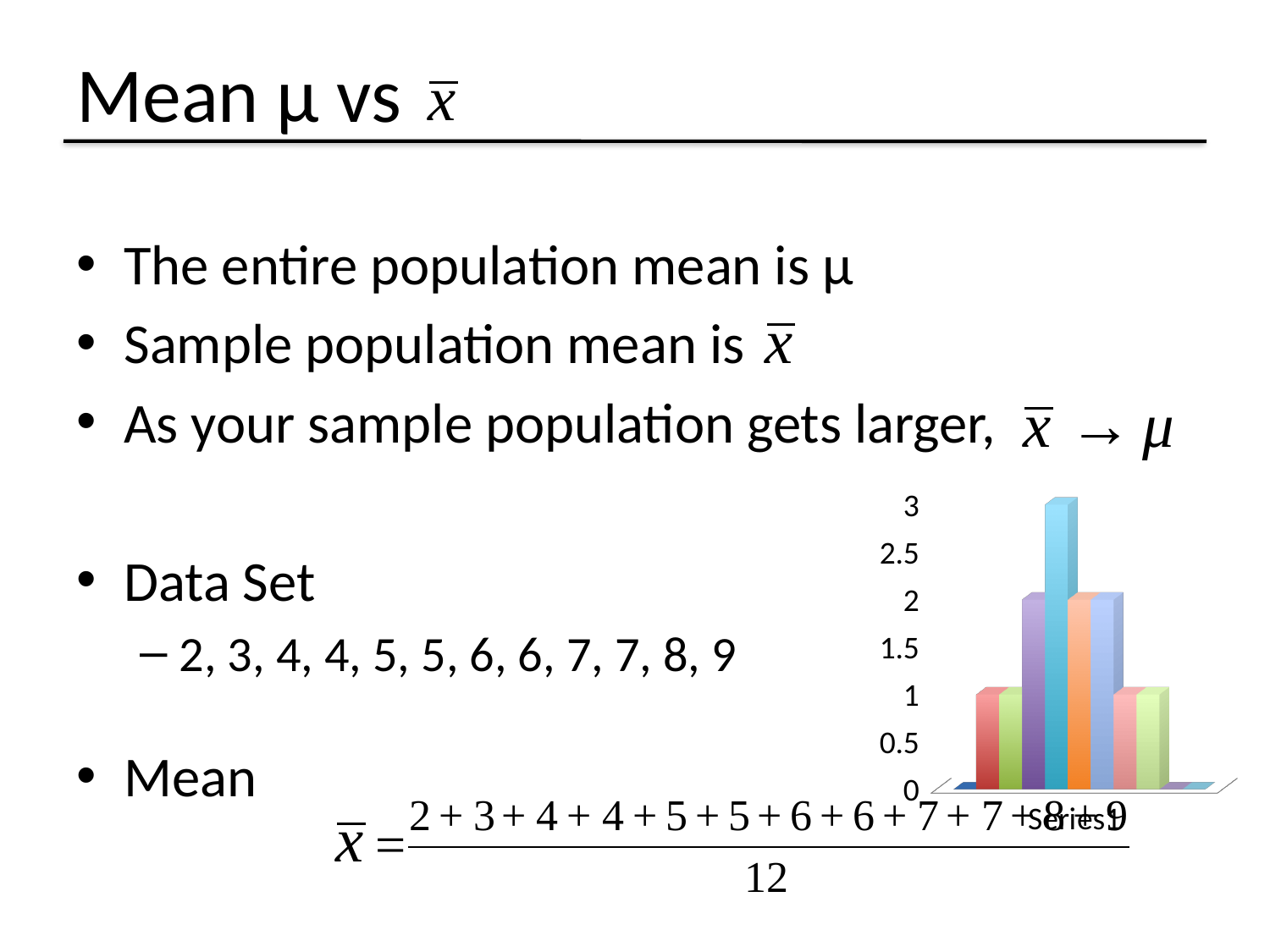
What is the difference between the tallest bar (3) and the red bar at the left (1)? 2 What value do the shortest visible bars (the red and green bars at the edges) reach? 1 How many bars in the chart reach a height of 3? 1 What value does the tallest bar in the chart reach? 3 What series name is printed below the chart? Series 1 Is the tallest bar in the chart greater or less than 2.5? greater What is the step between consecutive tick marks on the chart's vertical axis? 0.5 What is the highest value shown on the vertical axis of the chart? 3 Which is taller, the light blue bar in the centre or the red bar at the left? the light blue bar Is the red bar at the left of the chart greater or less than 1.5? less What kind of chart is shown on the slide? bar chart